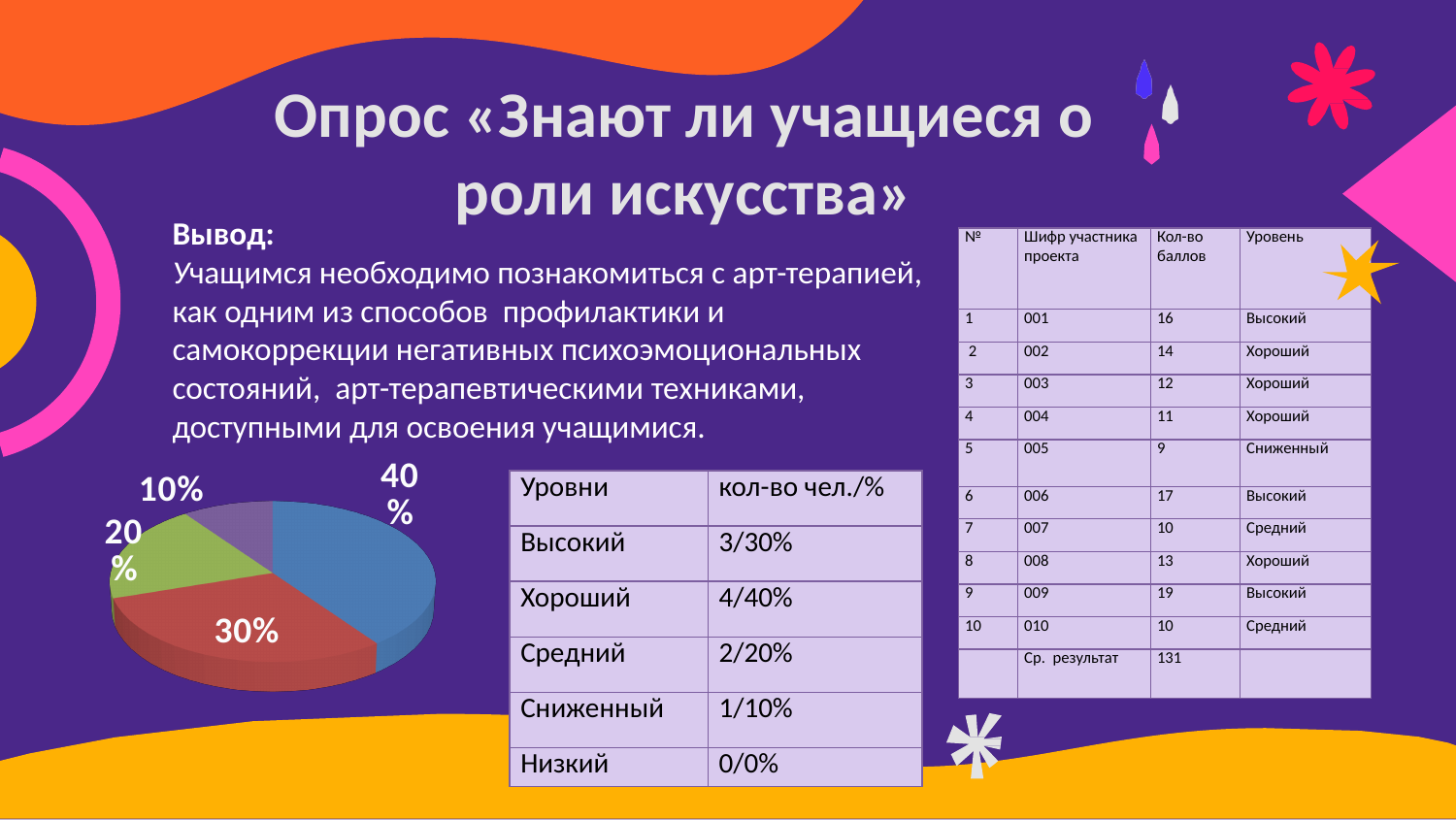
What do the four percentage labels on the pie chart add up to? 100% What is the largest value labelled on the pie chart? 40% How many slices does the pie chart have? 4 What kind of chart is shown on the slide? Pie chart What is the difference between the largest and smallest slice labels on the pie chart? 30% What percentage is labelled on the blue slice of the pie chart? 40% What percentage is labelled on the purple slice of the pie chart? 10% What percentage is labelled on the green slice of the pie chart? 20% What is the smallest value labelled on the pie chart? 10% Which slice of the pie chart is larger, the red one or the green one? The red one (30%) What percentage is labelled on the red slice of the pie chart? 30% Does the pie chart include a legend? No